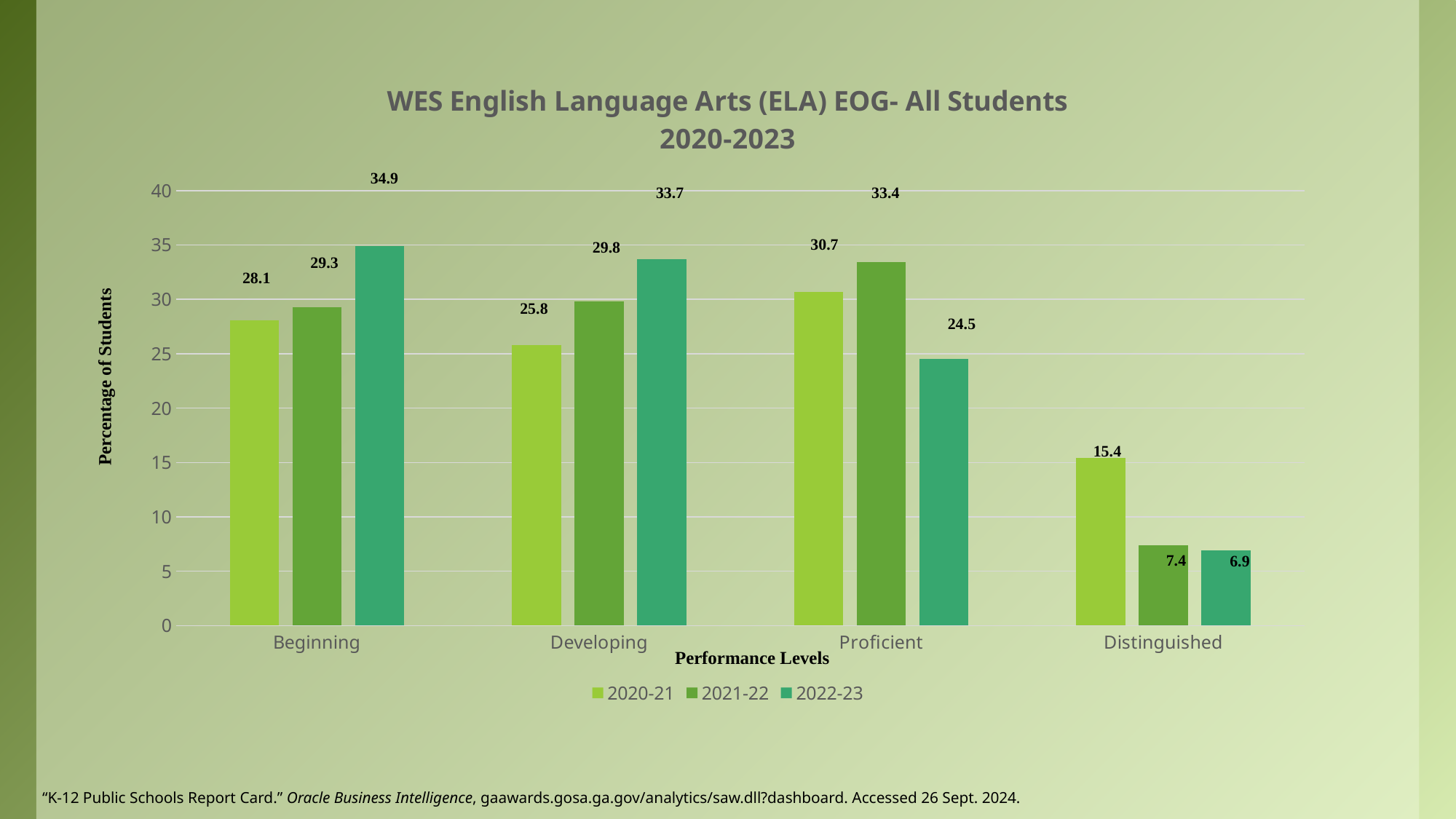
How many performance levels are shown on the x axis? 4 What is the value for Beginning in the 2022-23 series? 34.9 What kind of chart is shown on the slide? Bar chart Which performance level has the highest value in the 2020-21 series? Proficient Which is larger for Developing: the 2021-22 value or the 2022-23 value? 2022-23 How many series does the legend list? 3 What is the value for Distinguished in the 2020-21 series? 15.4 What is the difference between the 2020-21 and 2022-23 values for Proficient? 6.2 Which performance level has the lowest value in the 2022-23 series? Distinguished Do the values for Distinguished rise or fall from 2020-21 to 2022-23? Fall What is the title of the chart? WES English Language Arts (ELA) EOG- All Students 2020-2023 What is the value for Proficient in the 2021-22 series? 33.4